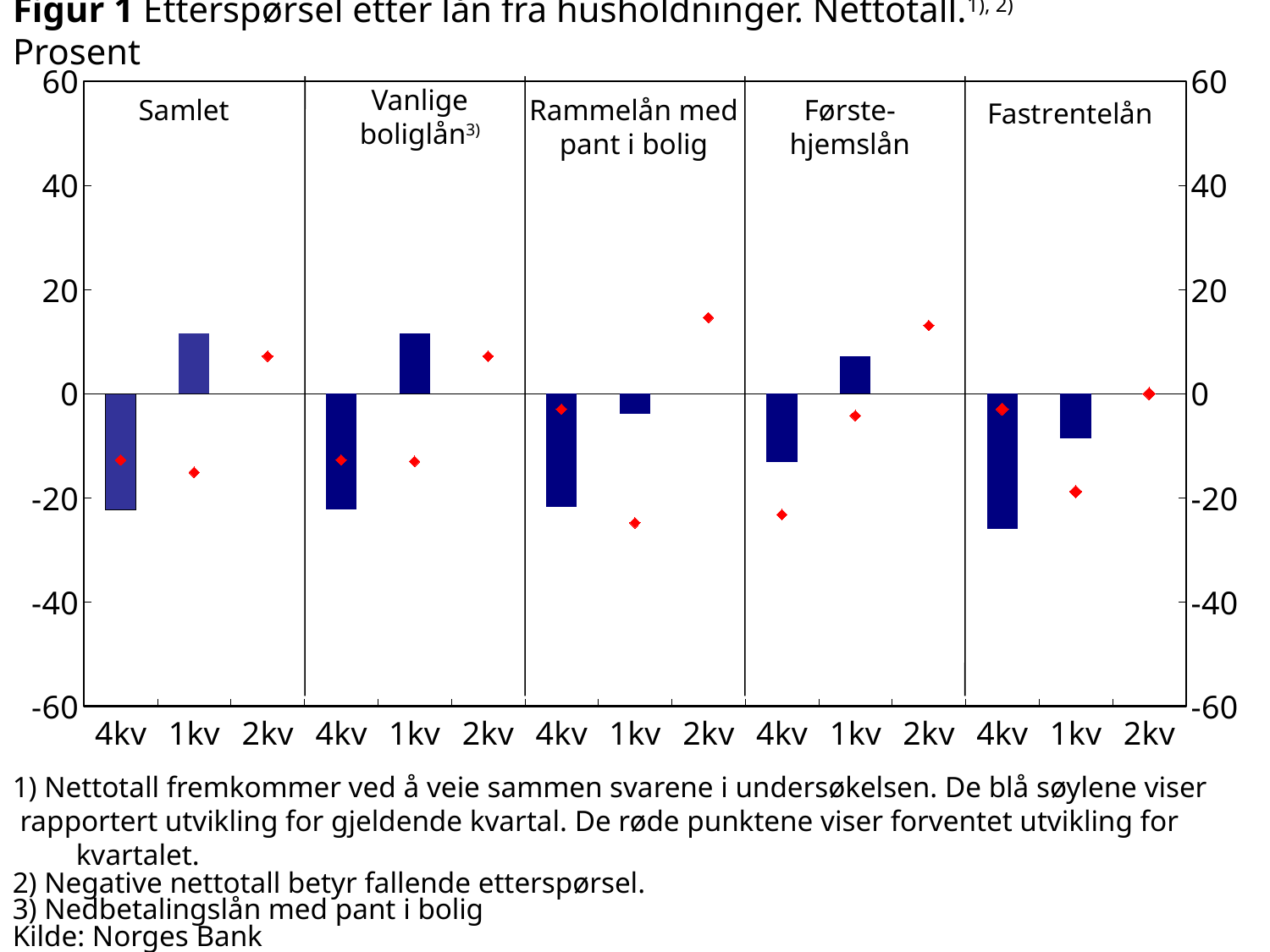
How many quarters are labelled on the x axis within each panel? 3 In the Samlet panel, does the bar value rise or fall from 4kv to 1kv? rise According to the footnote, what do the red points show? Forventet utvikling for kvartalet How many loan-category panels (Samlet, Vanlige boliglån, etc.) does the chart have? 5 In the Samlet panel, is the bar for 4kv greater or less than -20? less What kind of chart is shown on the slide? bar chart Which panel has the lowest bar for 4kv? Fastrentelån Which is lower, the 4kv bar for Fastrentelån or the 4kv bar for Førstehjemslån? Fastrentelån Which is lower, the 1kv bar for Rammelån med pant i bolig or the 1kv bar for Fastrentelån? Fastrentelån In the Førstehjemslån panel, is the bar for 4kv greater or less than -20? greater In the Rammelån med pant i bolig panel, is the red point for 2kv greater or less than 10? greater